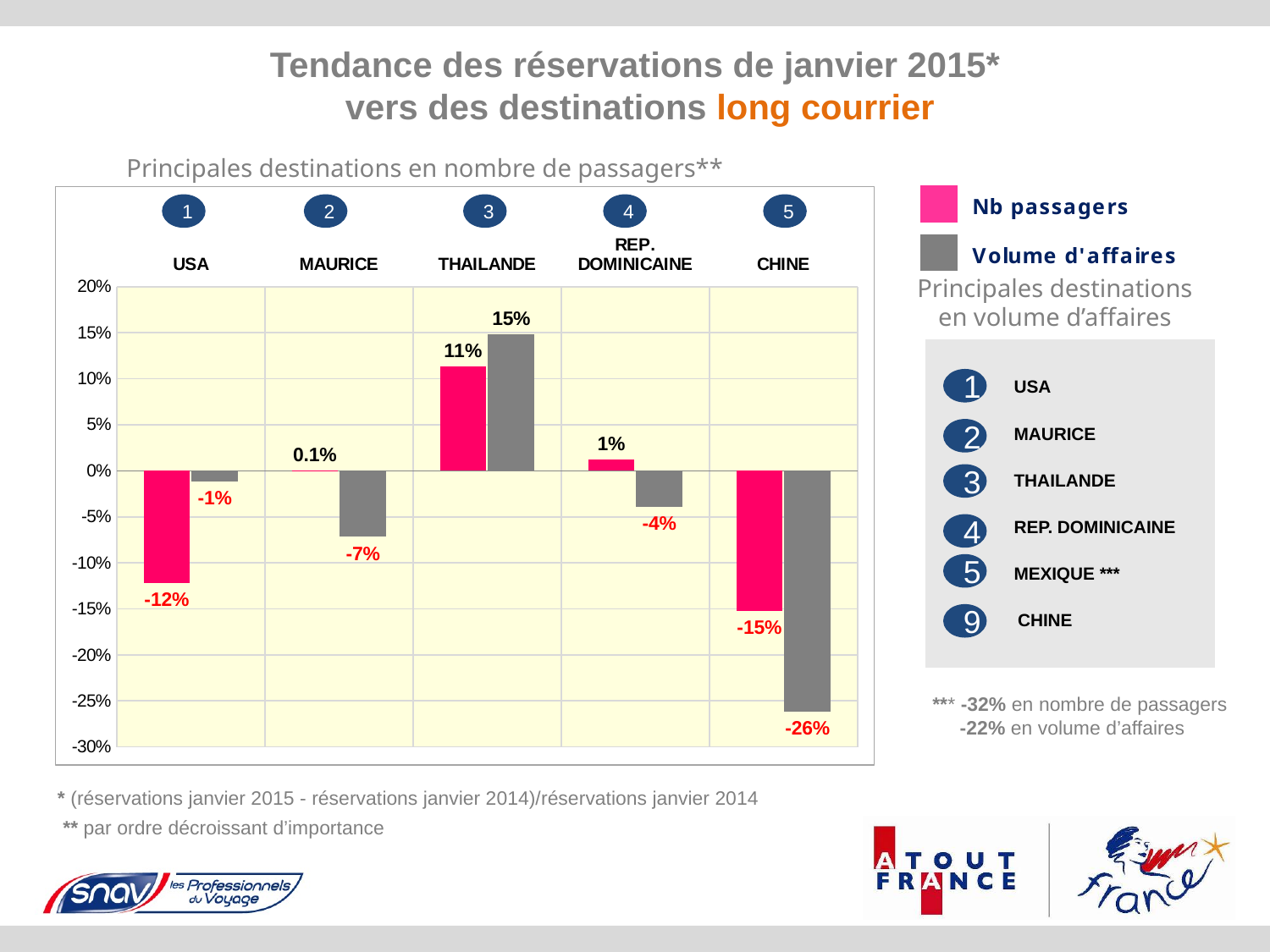
What is the Nb passagers value for MAURICE? 0.1% What is the difference between the Volume d'affaires and Nb passagers values for THAILANDE? 4 percentage points Which destination has the highest Volume d'affaires value? THAILANDE What kind of chart is shown on the slide? Bar chart Which is larger for USA: the Nb passagers value or the Volume d'affaires value? Volume d'affaires What is the Volume d'affaires value for CHINE? -26% How many destinations are shown on the x axis of the chart? 5 What is the Volume d'affaires value for REP. DOMINICAINE? -4% Which colour represents the Nb passagers series in the chart? Pink How many series does the legend list? 2 Which destination has the lowest Nb passagers value? CHINE What is the Nb passagers value for USA? -12%